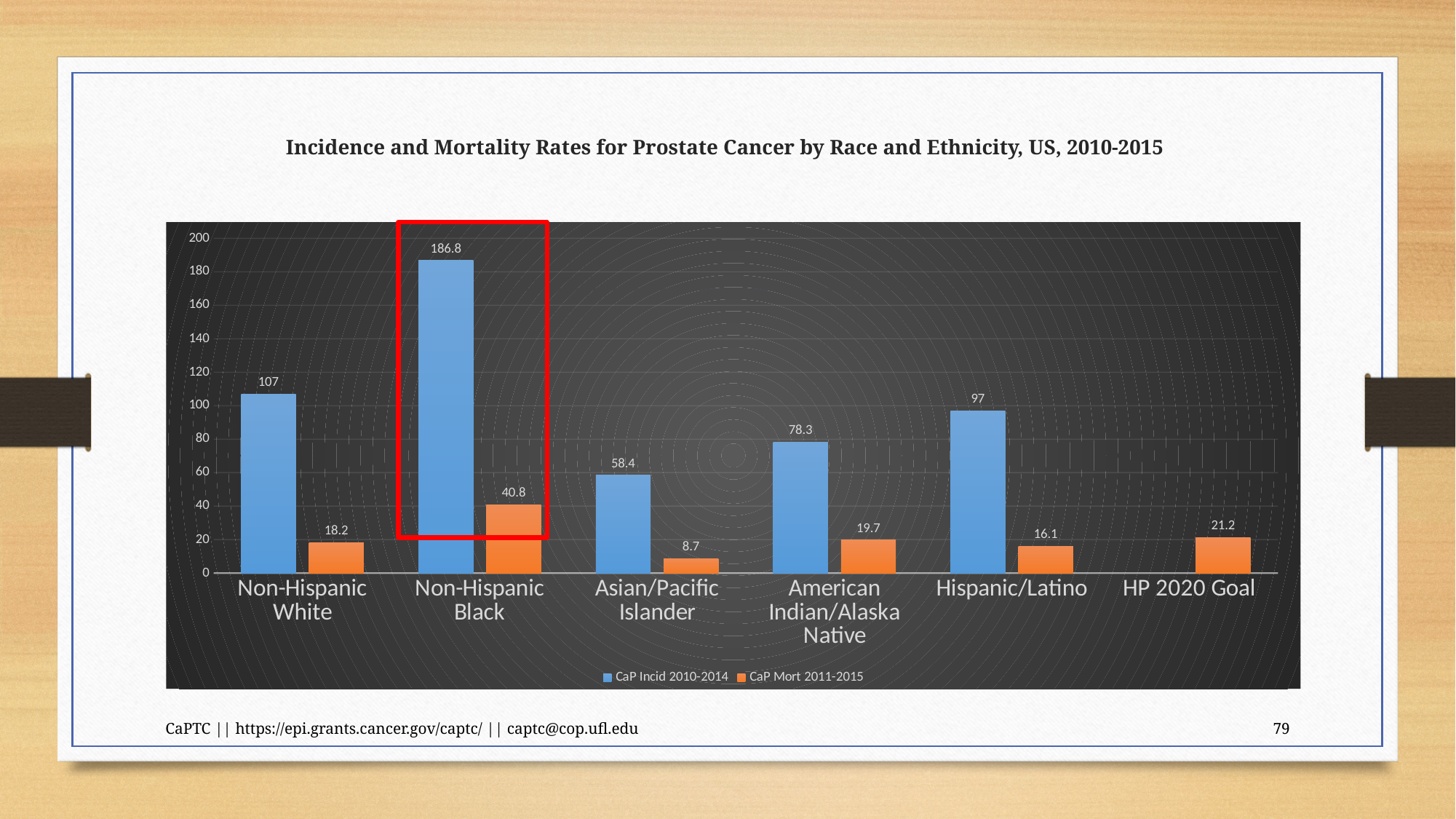
Which category is highlighted with a red box on the chart? Non-Hispanic Black What is the CaP Mort 2011-2015 value for HP 2020 Goal? 21.2 Which is larger: the CaP Incid 2010-2014 value for Hispanic/Latino or for American Indian/Alaska Native? Hispanic/Latino Which category has the highest CaP Incid 2010-2014 value? Non-Hispanic Black How many series does the legend list? 2 What is the difference between the CaP Incid 2010-2014 values for Non-Hispanic Black and Non-Hispanic White? 79.8 How many categories are shown on the x axis? 6 What is the CaP Mort 2011-2015 value for Asian/Pacific Islander? 8.7 What is the CaP Incid 2010-2014 value for Non-Hispanic Black? 186.8 Which category has the lowest CaP Mort 2011-2015 value? Asian/Pacific Islander What kind of chart is shown on the slide? Bar chart What is the title of the chart? Incidence and Mortality Rates for Prostate Cancer by Race and Ethnicity, US, 2010-2015